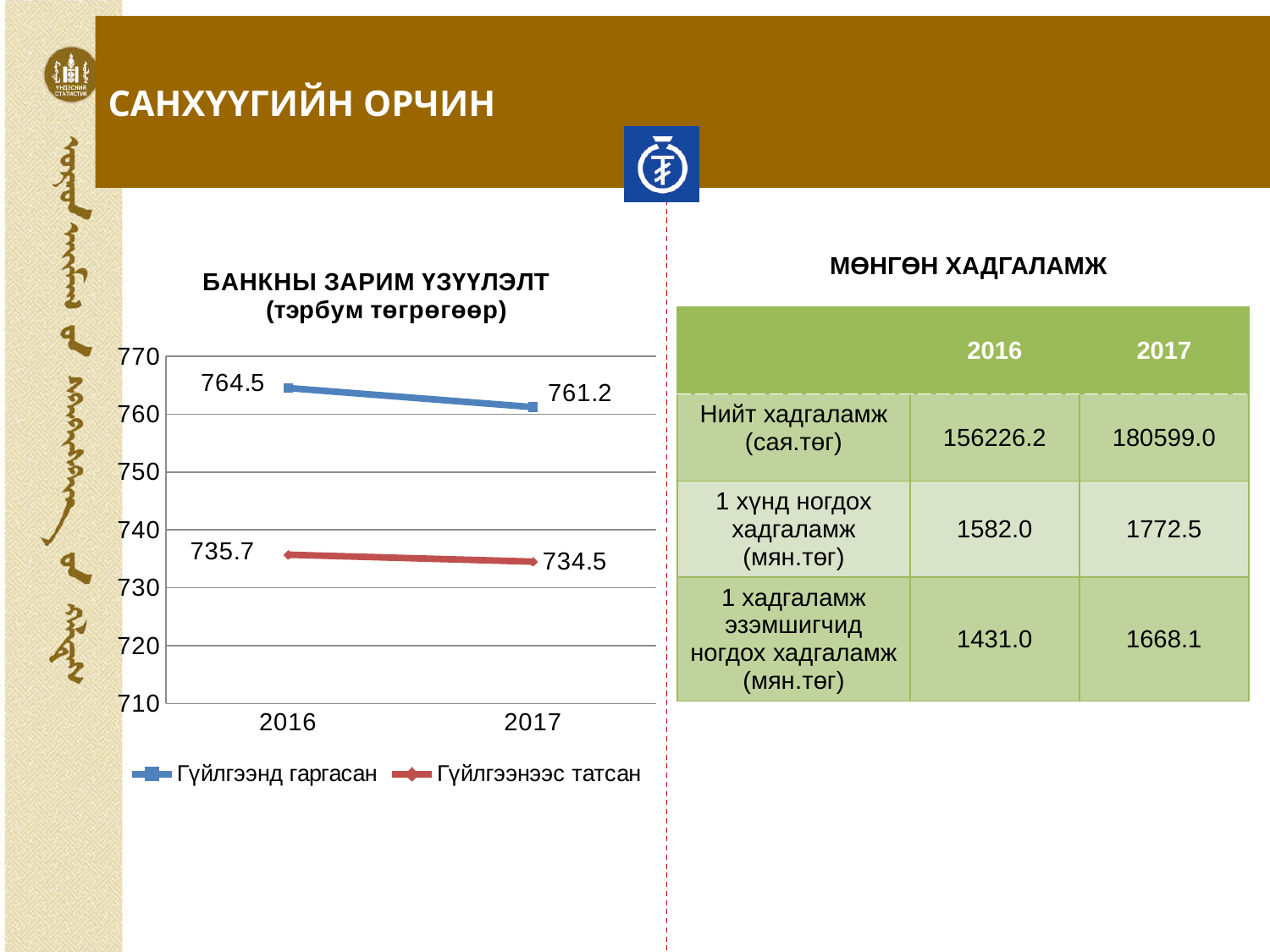
In the chart "БАНКНЫ ЗАРИМ ҮЗҮҮЛЭЛТ (тэрбум төгрөгөөр)", what is the value of Гүйлгээнд гаргасан in 2016? 764.5 How many series does the legend of the chart "БАНКНЫ ЗАРИМ ҮЗҮҮЛЭЛТ (тэрбум төгрөгөөр)" list? 2 In the chart "БАНКНЫ ЗАРИМ ҮЗҮҮЛЭЛТ (тэрбум төгрөгөөр)", what is the value of Гүйлгээнд гаргасан in 2017? 761.2 In the chart "БАНКНЫ ЗАРИМ ҮЗҮҮЛЭЛТ (тэрбум төгрөгөөр)", by how much did Гүйлгээнд гаргасан change from 2016 to 2017? 3.3 What kind of chart is "БАНКНЫ ЗАРИМ ҮЗҮҮЛЭЛТ (тэрбум төгрөгөөр)"? line chart In the chart "БАНКНЫ ЗАРИМ ҮЗҮҮЛЭЛТ (тэрбум төгрөгөөр)", is the value of Гүйлгээнээс татсан in 2016 greater or less than 740? less In the chart "БАНКНЫ ЗАРИМ ҮЗҮҮЛЭЛТ (тэрбум төгрөгөөр)", what is the difference between Гүйлгээнд гаргасан and Гүйлгээнээс татсан in 2017? 26.7 How many years are shown on the x axis of the chart "БАНКНЫ ЗАРИМ ҮЗҮҮЛЭЛТ (тэрбум төгрөгөөр)"? 2 In the chart "БАНКНЫ ЗАРИМ ҮЗҮҮЛЭЛТ (тэрбум төгрөгөөр)", does the Гүйлгээнд гаргасан series rise or fall from 2016 to 2017? fall In the chart "БАНКНЫ ЗАРИМ ҮЗҮҮЛЭЛТ (тэрбум төгрөгөөр)", what is the value of Гүйлгээнээс татсан in 2016? 735.7 In the chart "БАНКНЫ ЗАРИМ ҮЗҮҮЛЭЛТ (тэрбум төгрөгөөр)", what is the value of Гүйлгээнээс татсан in 2017? 734.5 In the chart "БАНКНЫ ЗАРИМ ҮЗҮҮЛЭЛТ (тэрбум төгрөгөөр)", which series has the higher value in 2016, Гүйлгээнд гаргасан or Гүйлгээнээс татсан? Гүйлгээнд гаргасан